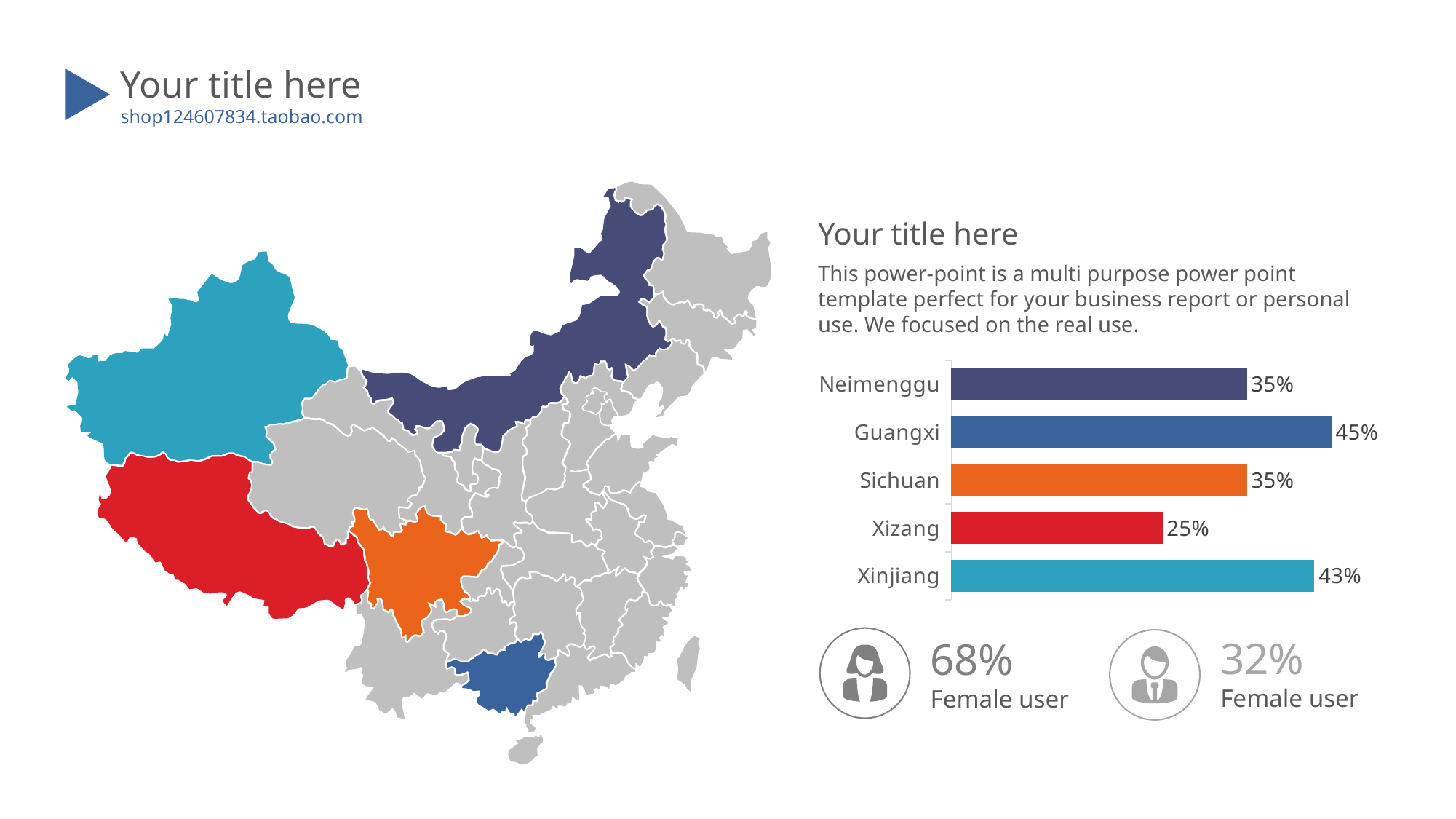
What kind of chart is shown on the slide? bar chart Which has a larger value, Xinjiang or Neimenggu? Xinjiang What is the value for Neimenggu in the bar chart? 35% What is the value for Xizang in the bar chart? 25% Which category has the highest value in the bar chart? Guangxi What is the difference between the values for Guangxi and Xizang? 20% How many categories are shown in the bar chart? 5 What is the difference between the values for Xinjiang and Sichuan? 8% What colour is the bar for Sichuan? orange What is the value for Guangxi in the bar chart? 45% What is the value for Xinjiang in the bar chart? 43% Which category has the lowest value in the bar chart? Xizang